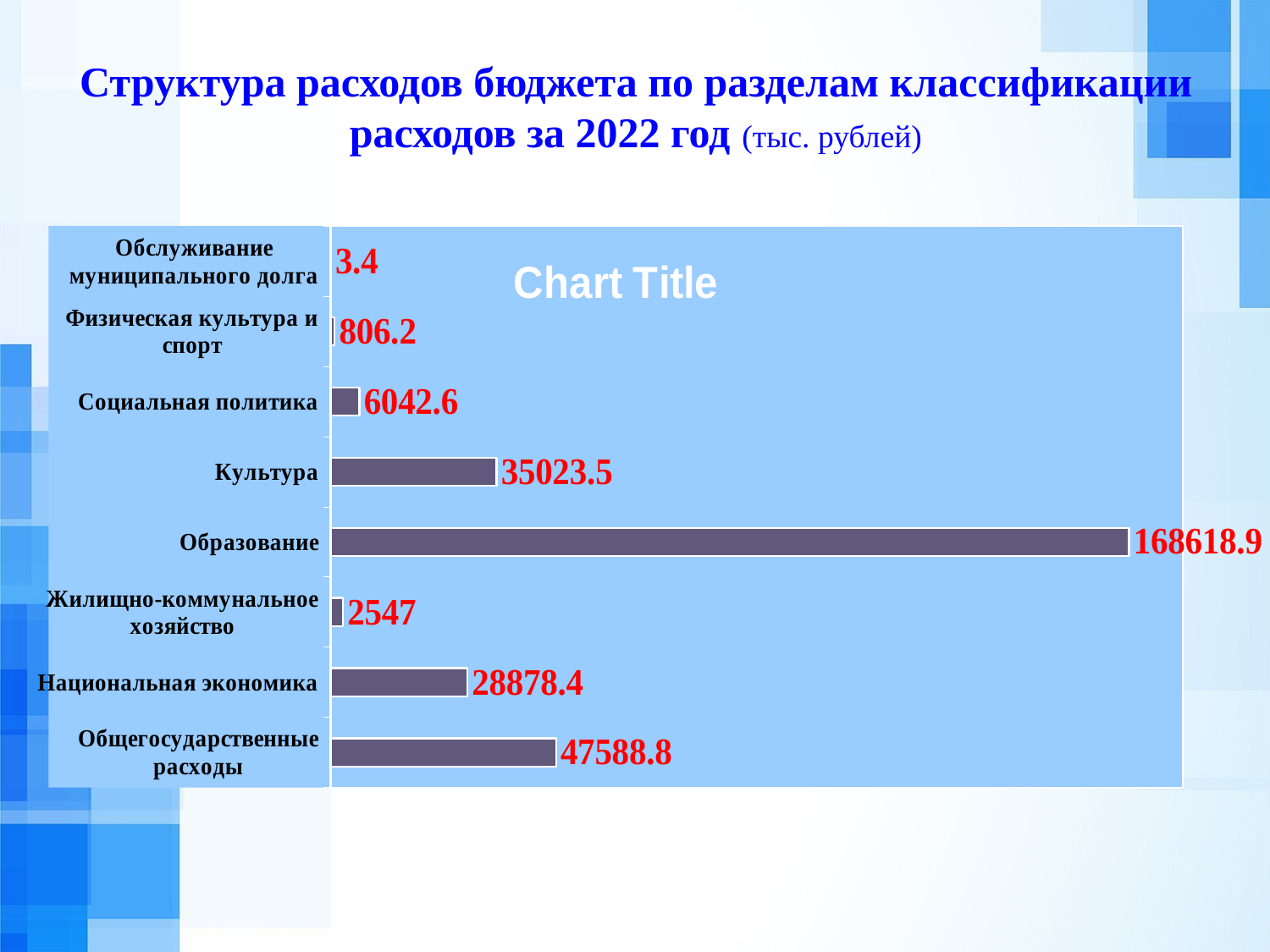
What is the difference between Культура and Социальная политика? 28980.9 What is the value for Жилищно-коммунальное хозяйство? 2547 What is the value for Культура? 35023.5 What is the value for Обслуживание муниципального долга? 3.4 What kind of chart is shown on the slide? Bar chart Which is larger, Национальная экономика or Культура? Культура What title is printed inside the chart area? Chart Title Which category has the highest value? Образование How many categories are shown in the chart? 8 What is the difference between Общегосударственные расходы and Национальная экономика? 18710.4 Which category has the lowest value? Обслуживание муниципального долга What is the value for Образование? 168618.9